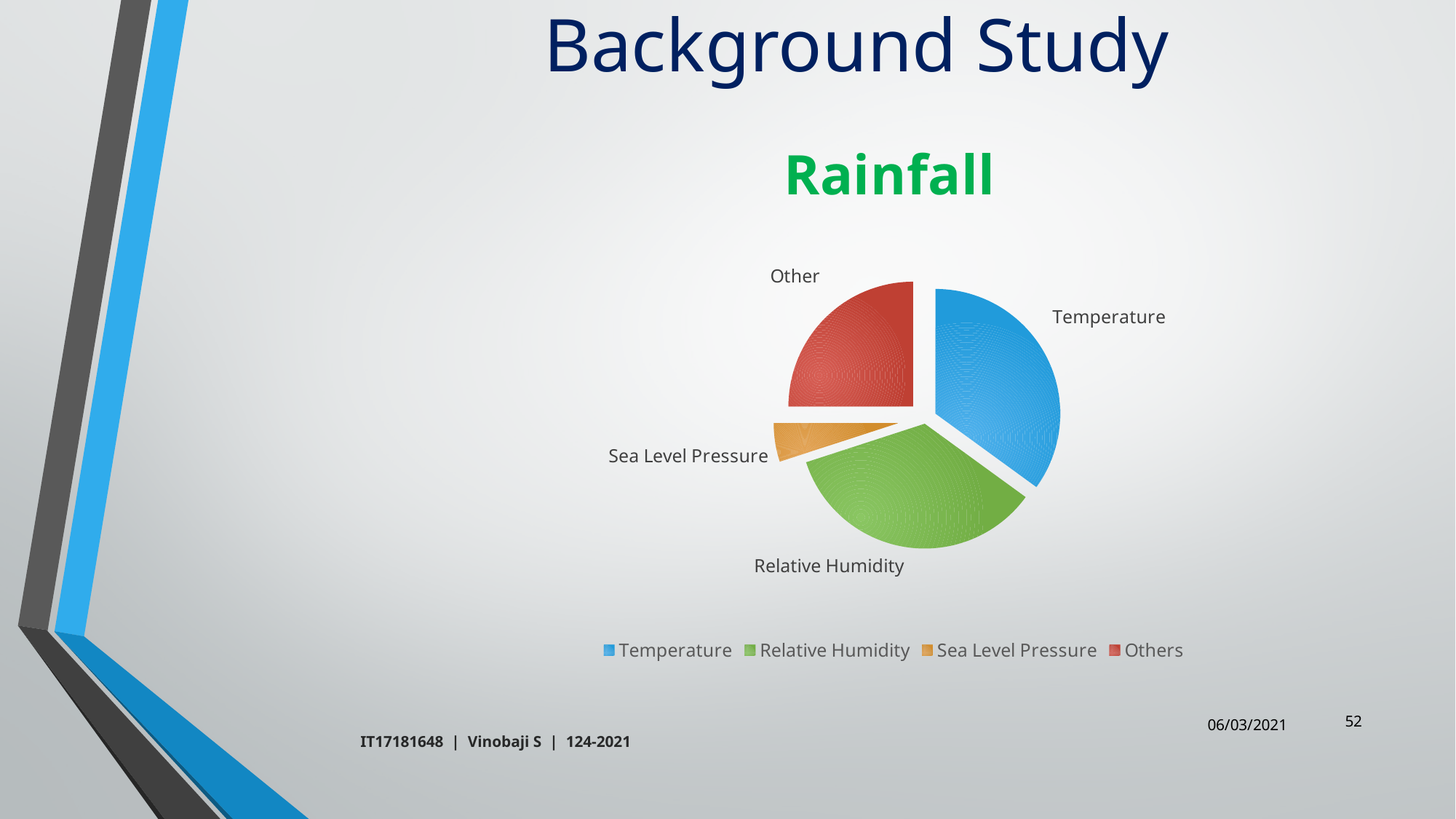
What kind of chart is shown on the slide? pie chart How many slices does the pie chart have? 4 Which slice is larger, Temperature or Sea Level Pressure? Temperature What colour is the Temperature slice of the pie chart? blue Which slice is larger, Other or Sea Level Pressure? Other Which slice of the pie chart is the smallest? Sea Level Pressure How many entries does the legend of the pie chart list? 4 Which slice is larger, Relative Humidity or Sea Level Pressure? Relative Humidity What is the title shown above the pie chart? Rainfall